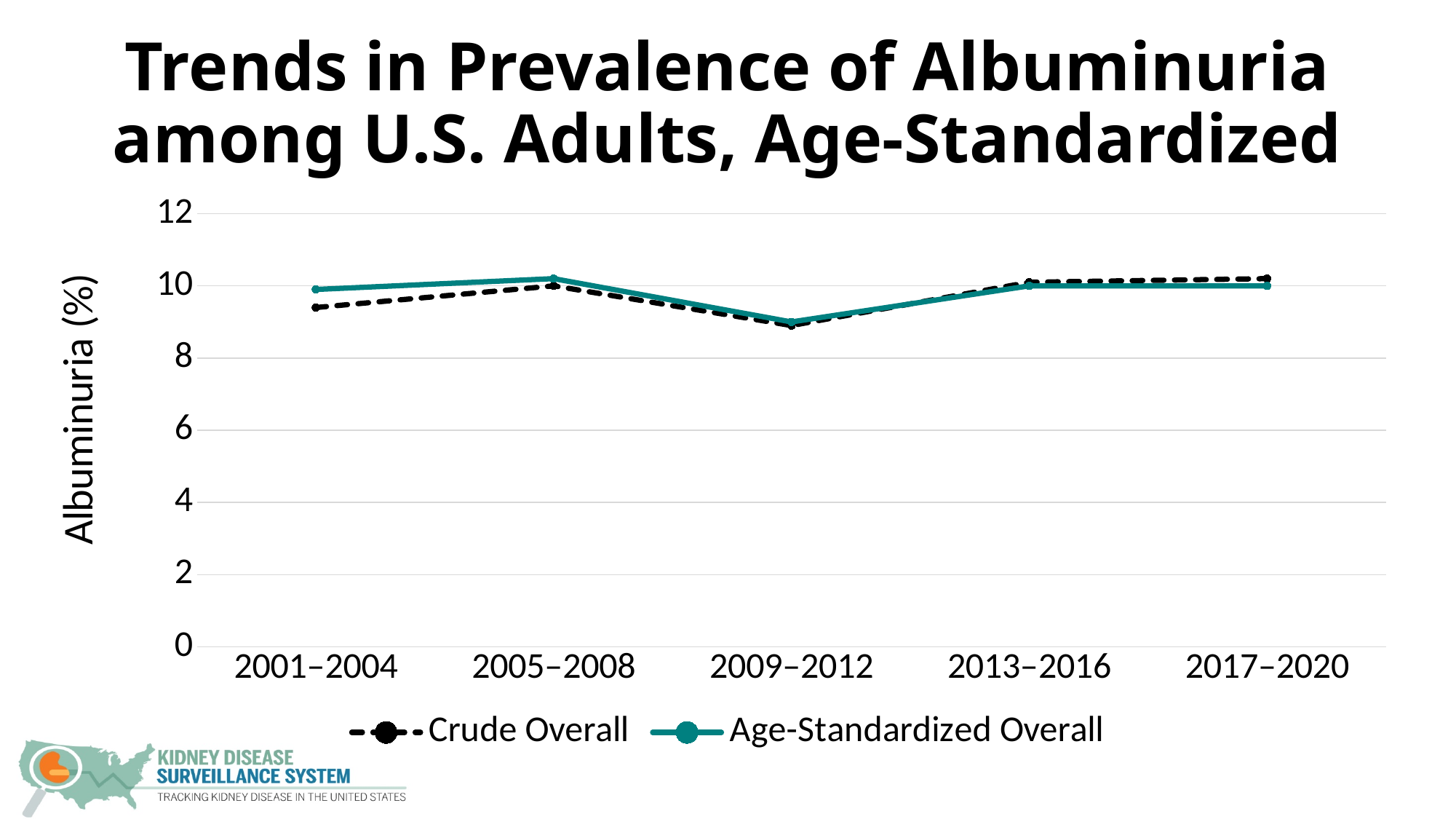
What kind of chart is shown on the slide? Line chart In 2001–2004, which series has the higher value, Crude Overall or Age-Standardized Overall? Age-Standardized Overall Which series is drawn with a dashed black line? Crude Overall Is the Crude Overall value for 2009–2012 greater or less than 8? greater Is the Crude Overall value for 2001–2004 greater or less than 10? less How many series does the legend list? 2 Does the Crude Overall series rise or fall from 2005–2008 to 2009–2012? Fall What is the label on the y axis? Albuminuria (%) How many time periods are shown on the x axis? 5 Which time period has the lowest value for the Crude Overall series? 2009–2012 Which time period has the lowest value for the Age-Standardized Overall series? 2009–2012 Is the Age-Standardized Overall value for 2009–2012 greater or less than 10? less